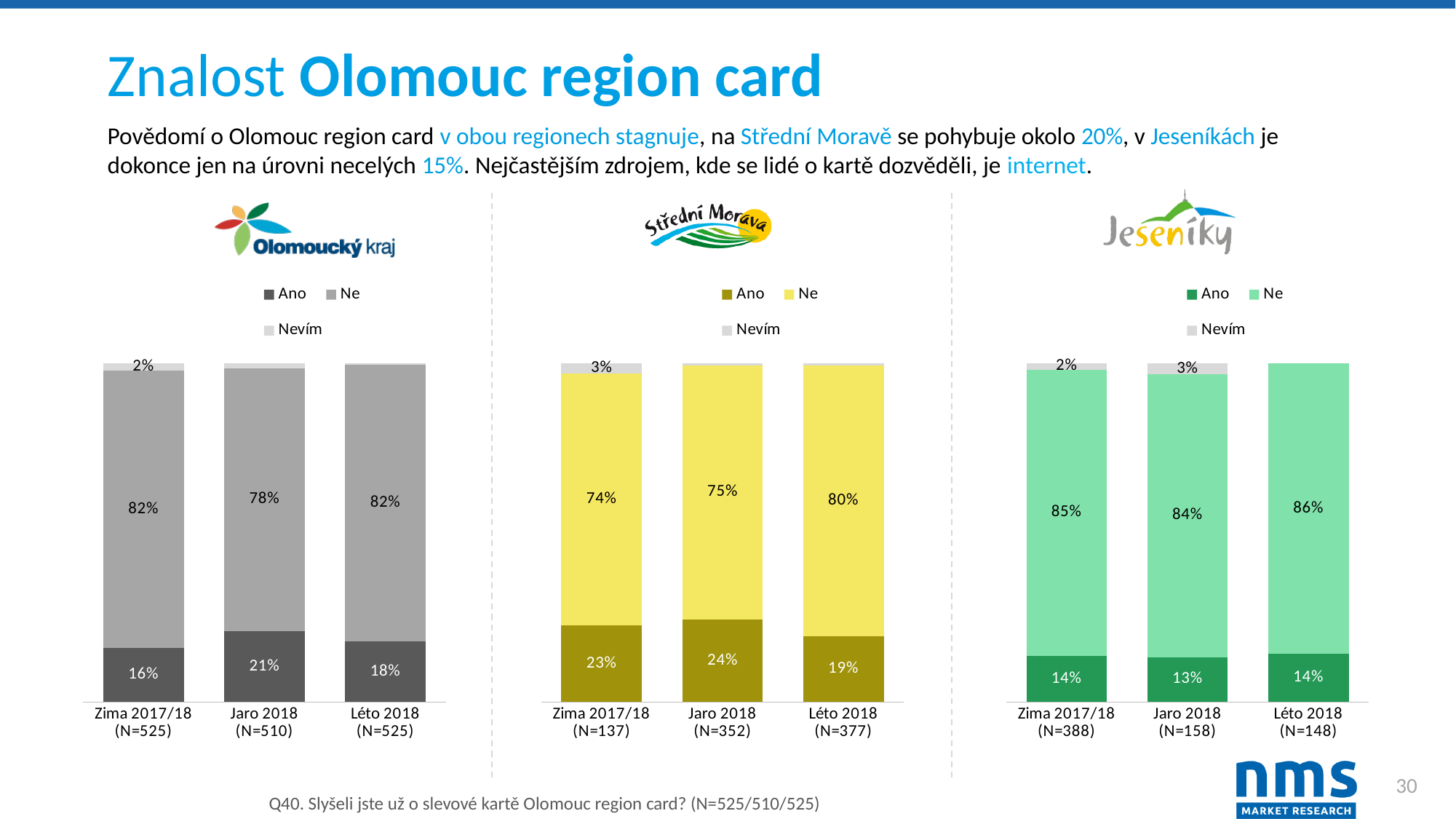
In the left chart (Olomoucký kraj), which period has the lowest Ano value? Zima 2017/18 How many periods (bars) are shown in the left chart (Olomoucký kraj)? 3 What kind of chart is the right chart (Jeseníky)? Stacked bar chart In the middle chart (Střední Morava), what is the total of the Zima 2017/18 bar (Ano + Ne + Nevím)? 100% In the right chart (Jeseníky), what is the value of Ano for Jaro 2018? 13% In the right chart (Jeseníky), which is larger: the Ne value for Léto 2018 or for Jaro 2018? Léto 2018 In the middle chart (Střední Morava), what is the difference between the Ano values for Jaro 2018 and Léto 2018? 5% In the middle chart (Střední Morava), which period has the highest Ano value? Jaro 2018 How many series does the legend of the middle chart (Střední Morava) list? 3 In the right chart (Jeseníky), what is the value of Nevím for Zima 2017/18? 2% In the middle chart (Střední Morava), what is the value of Ne for Léto 2018? 80% In the left chart (Olomoucký kraj), what is the value of Ano for Jaro 2018? 21%